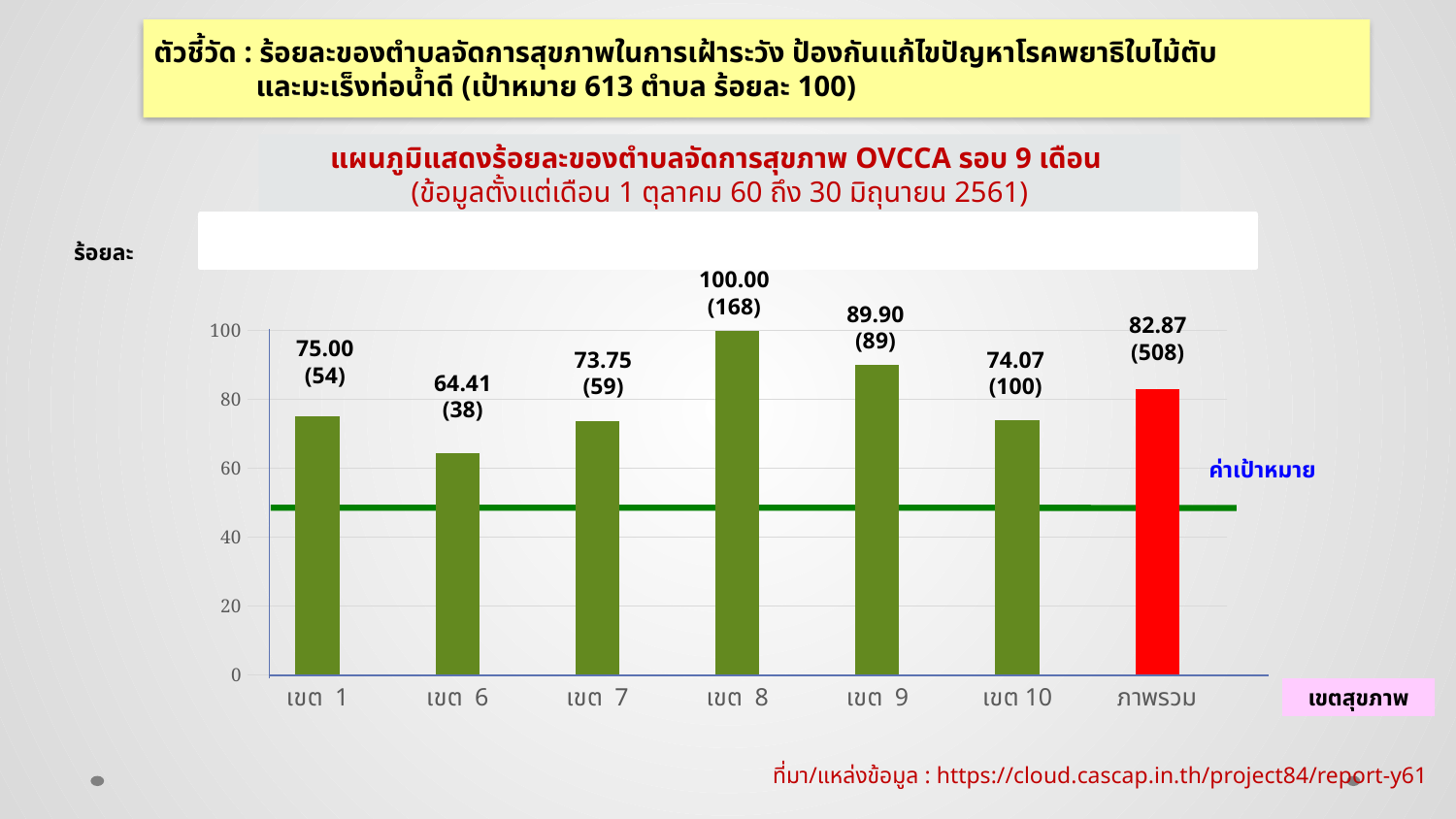
What is the percentage value shown for ภาพรวม? 82.87 How many categories are shown on the x axis? 7 What is the difference between the percentage values for เขต 8 and เขต 9? 10.10 Which bar is coloured red instead of green? ภาพรวม Which category has the lowest percentage value? เขต 6 Is the value for เขต 6 greater or less than 60? greater What number is shown in parentheses under the value for เขต 10? (100) Which has a larger percentage value, เขต 1 or เขต 7? เขต 1 Which category has the highest percentage value? เขต 8 What kind of chart is shown on the slide? bar chart What is the percentage value shown for เขต 6? 64.41 What is the percentage value shown for เขต 8? 100.00